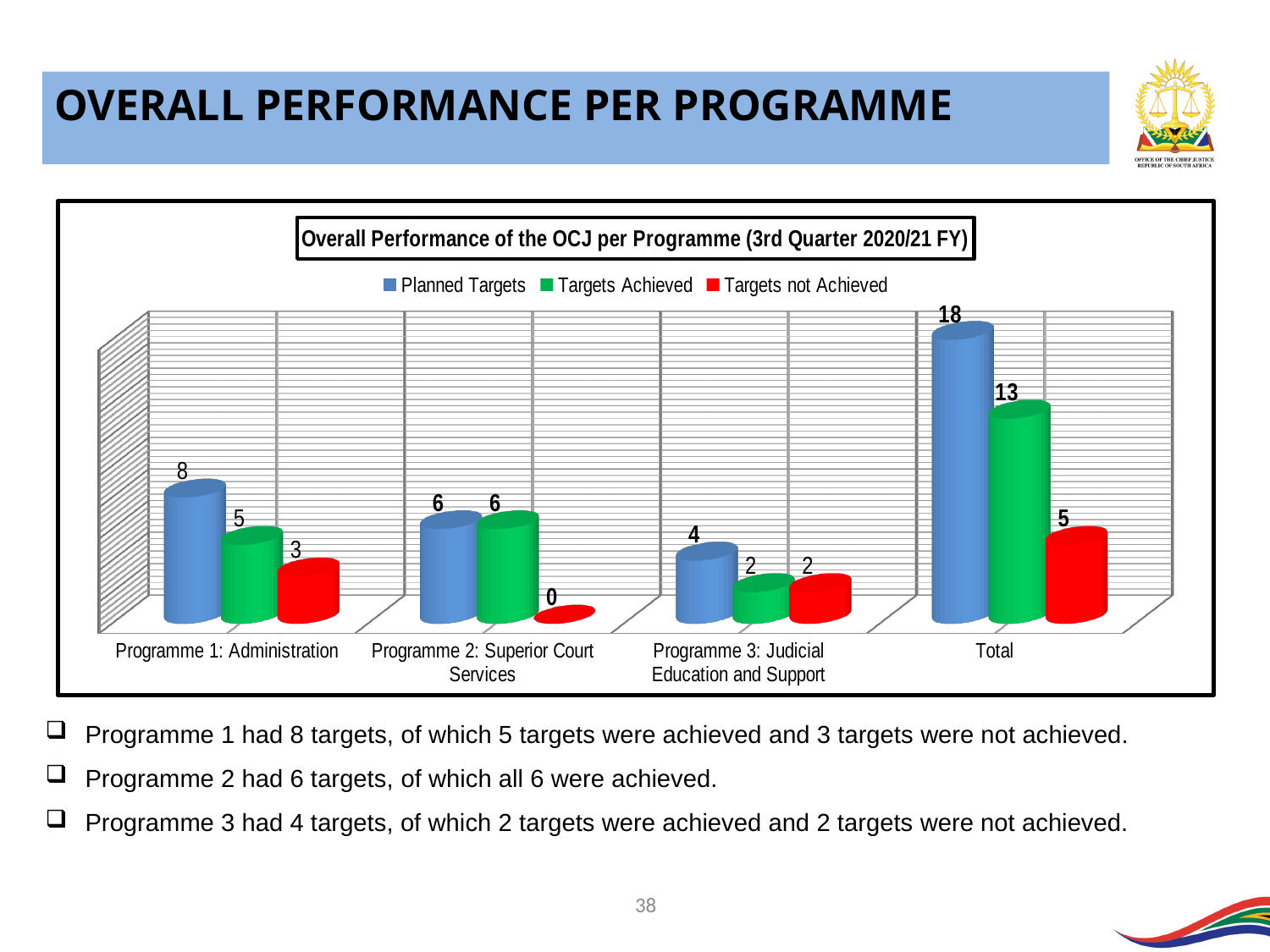
What is the title of the chart? Overall Performance of the OCJ per Programme (3rd Quarter 2020/21 FY) What is the difference between Planned Targets and Targets Achieved for Total? 5 What is the value of Targets Achieved for Total? 13 Which category has the highest Planned Targets value? Total Which is larger for Programme 1: Administration, Targets Achieved or Targets not Achieved? Targets Achieved Which category has the lowest Targets not Achieved value? Programme 2: Superior Court Services How many series does the legend list? 3 How many categories are shown on the x axis? 4 What is the value of Targets Achieved for Programme 2: Superior Court Services? 6 What is the value of Targets not Achieved for Programme 3: Judicial Education and Support? 2 What kind of chart is shown? Bar chart What is the value of Planned Targets for Programme 1: Administration? 8